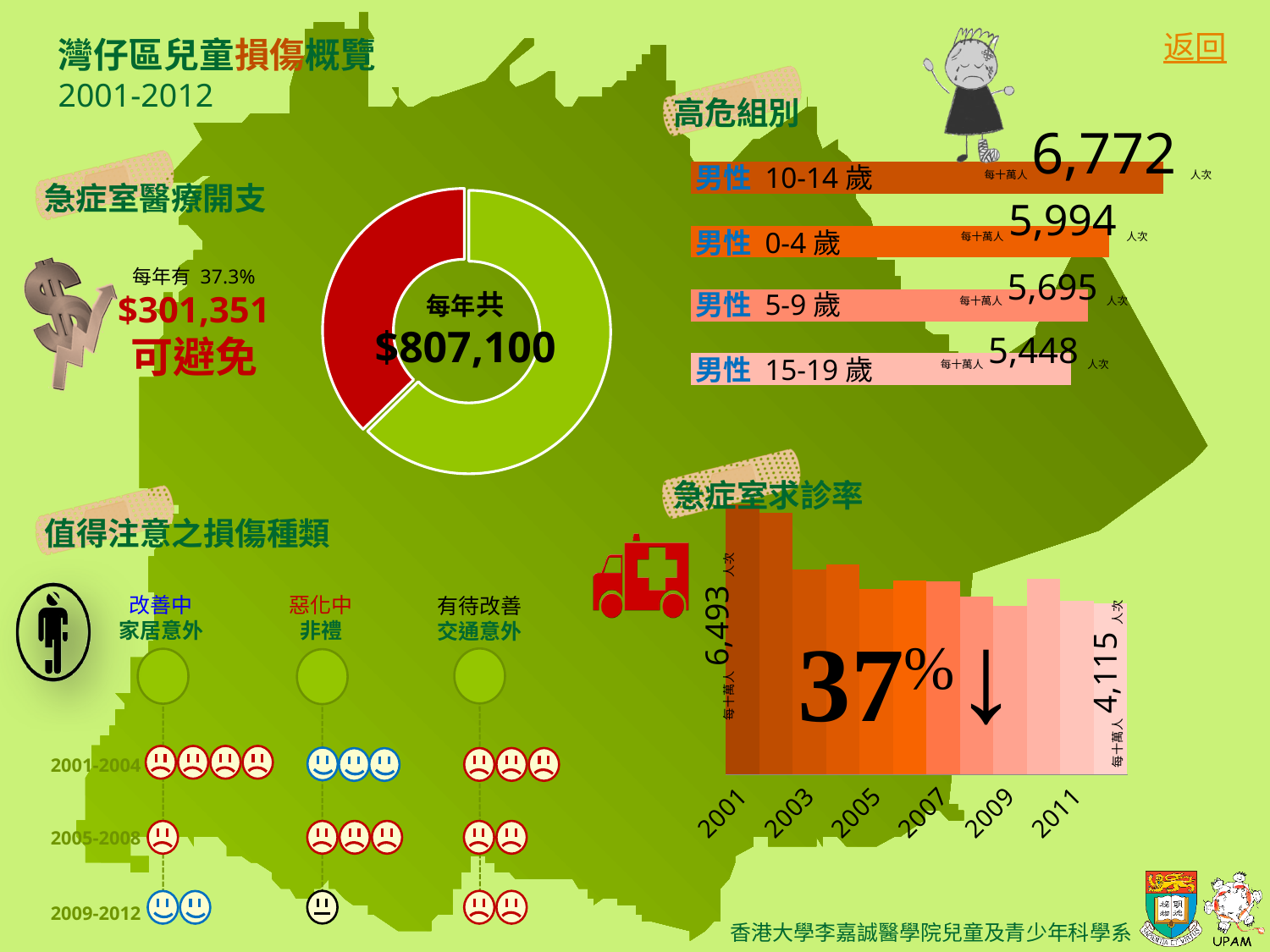
In the 急症室求診率 chart, do the values rise or fall from 2001 to 2011? Fall In the 高危組別 bar chart, what is the value for 男性 15-19 歲? 5,448 In the 高危組別 bar chart, which group has the highest value? 男性 10-14 歲 In the 高危組別 bar chart, what is the value for 男性 10-14 歲? 6,772 In the 急症室求診率 chart, what is the value labelled on the 2001 bar? 6,493 In the 高危組別 bar chart, how many groups are shown? 4 What kind of chart is the 高危組別 chart? Bar chart In the 急症室求診率 chart, what is the value labelled on the rightmost bar? 4,115 In the 高危組別 bar chart, what is the difference between the values for 男性 10-14 歲 and 男性 0-4 歲? 778 In the 急症室求診率 chart, what percentage change is printed on the chart? 37%↓ In the 急症室醫療開支 donut chart, what is the total annual amount shown in the centre? $807,100 In the 高危組別 bar chart, which group has the lowest value? 男性 15-19 歲